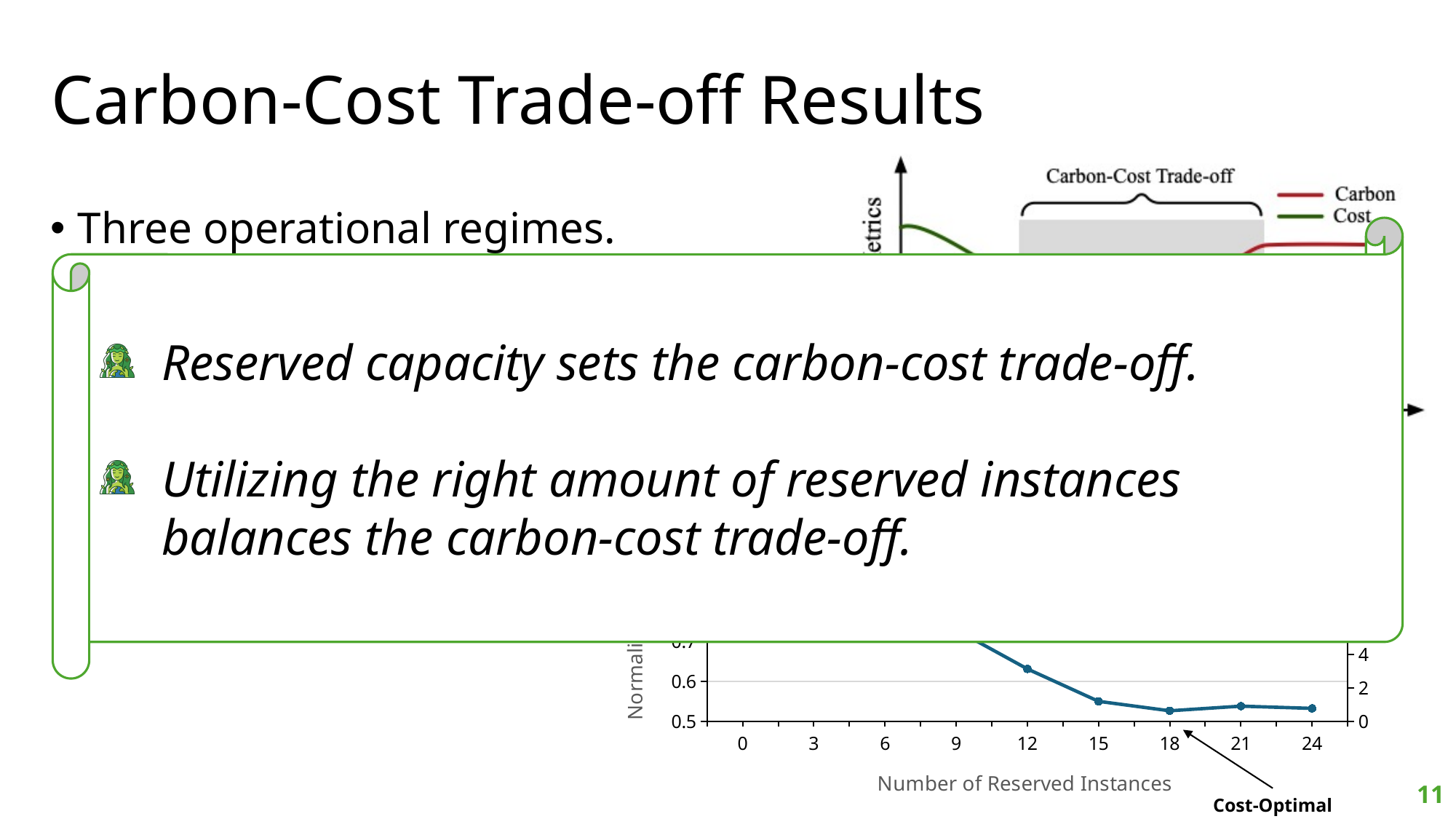
In the bottom chart, which is larger: the value at 12 reserved instances or the value at 18 reserved instances? 12 reserved instances In the bottom chart, is the value at 24 reserved instances greater or less than 0.6? less In the bottom chart, is the value at 15 reserved instances greater or less than 0.6? less How many series does the legend of the small schematic chart at the top right list? 2 In the bottom chart, is the value at 12 reserved instances greater or less than 0.6? greater What kind of chart is the chart at the bottom of the slide? line chart In the bottom chart, what is the label of the x axis? Number of Reserved Instances In the bottom chart, which is larger: the value at 12 reserved instances or the value at 15 reserved instances? 12 reserved instances In the bottom chart, does the line rise or fall between 12 and 18 reserved instances? fall In the bottom chart, which number of reserved instances is annotated as "Cost-Optimal"? 18